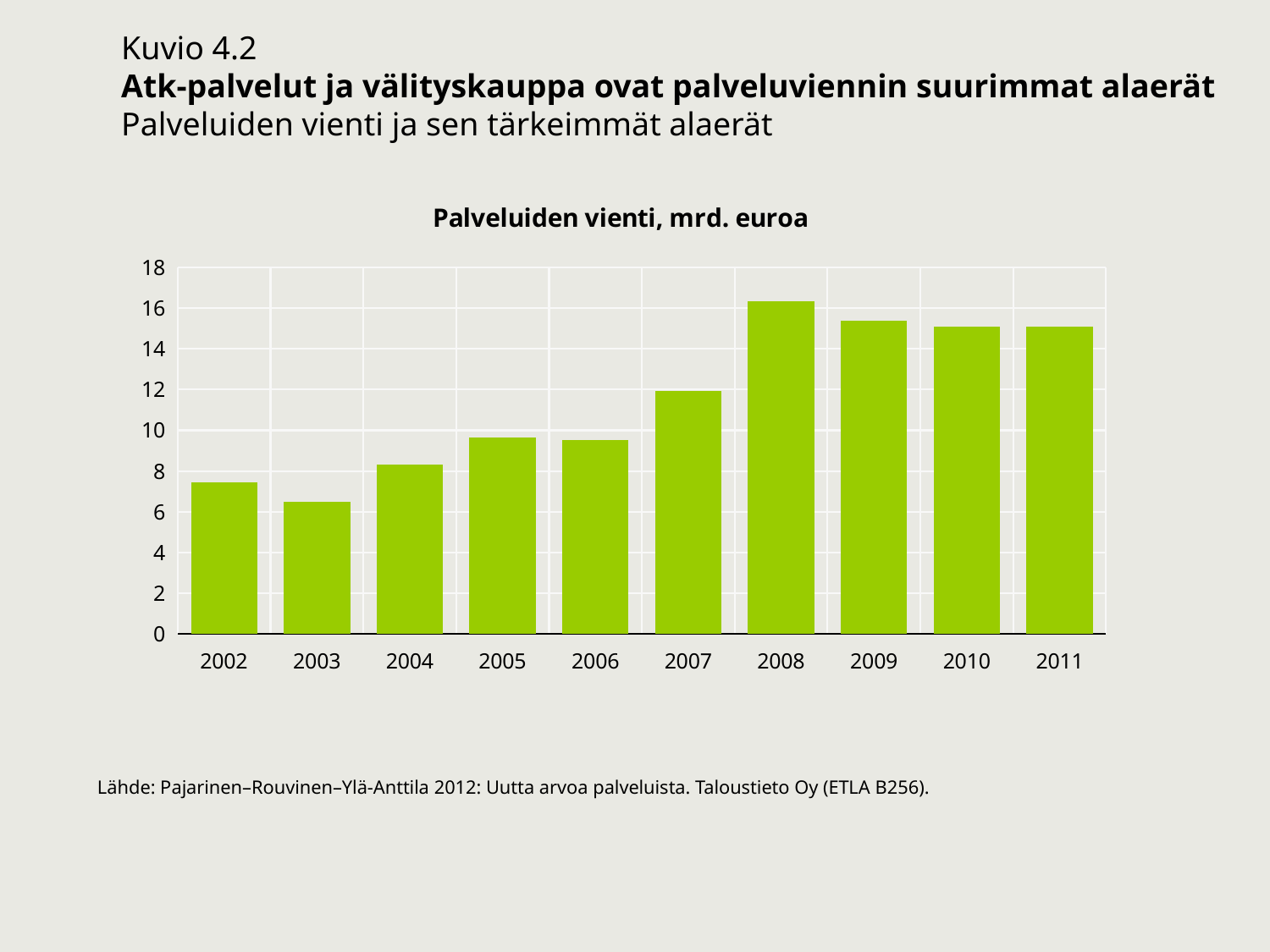
Which year has the larger value, 2002 or 2004? 2004 Is the value for 2003 greater or less than 8? less Which year has the highest value in the chart? 2008 Is the value for 2009 greater or less than 14? greater Is the value for 2008 greater or less than 14? greater Which year has the lowest value in the chart? 2003 What kind of chart is shown on the slide? bar chart How many years are shown on the x axis of the chart? 10 Do the values generally rise or fall from 2003 to 2008? rise Which year has the larger value, 2008 or 2009? 2008 What is the title of the chart? Palveluiden vienti, mrd. euroa